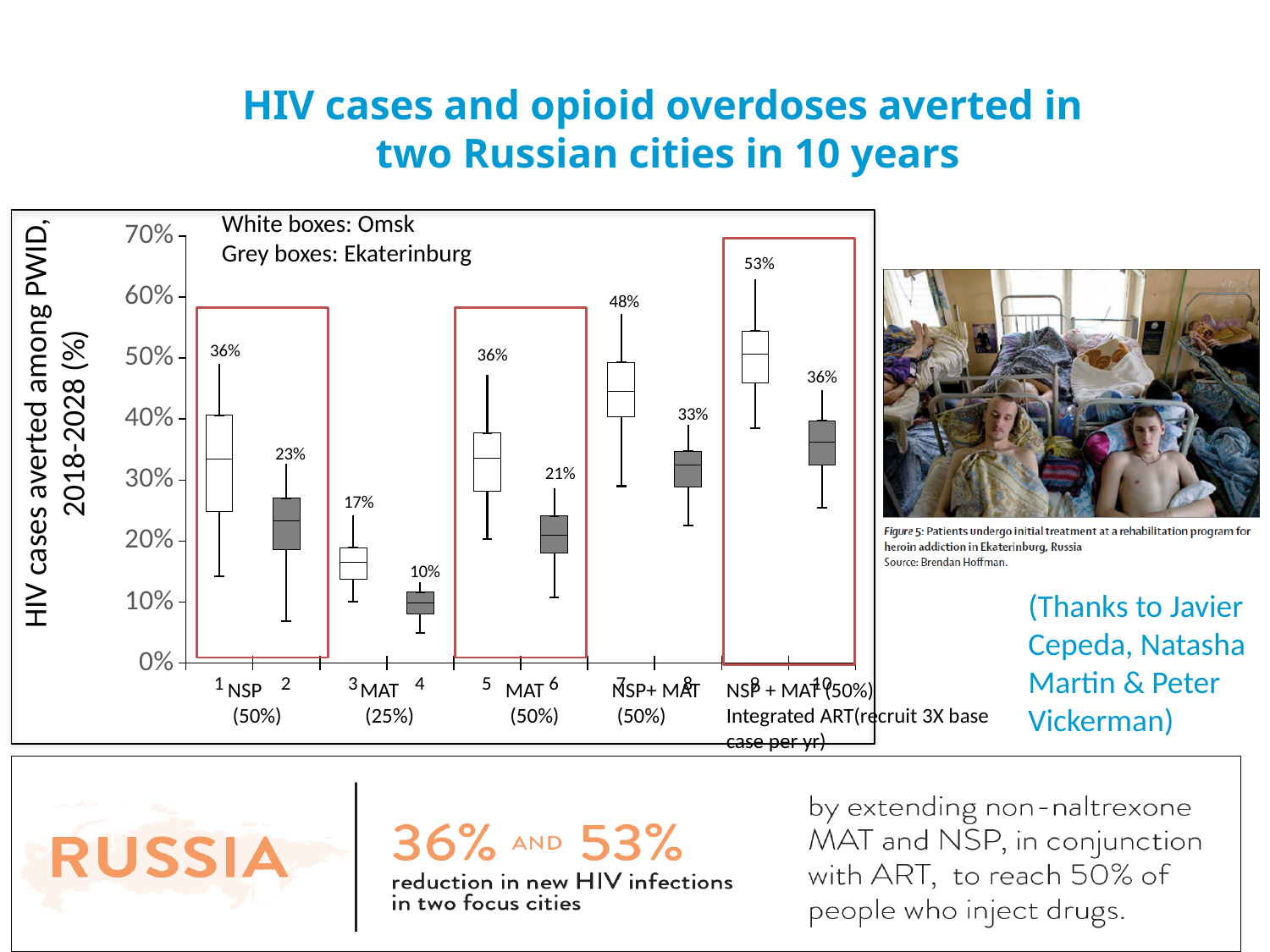
Which city do the grey boxes represent? Ekaterinburg What is the difference between the Omsk labelled values for the MAT (50%) and MAT (25%) scenarios? 19% What is the labelled value for Ekaterinburg (grey box) under the MAT (25%) scenario? 10% What is the labelled value for Omsk under the NSP + MAT (50%) Integrated ART scenario? 53% What is the difference between the Omsk and Ekaterinburg labelled values under the NSP (50%) scenario? 13% Which scenario has the highest labelled value for Omsk (white boxes)? NSP + MAT (50%) Integrated ART Which scenario has the lowest labelled value for Ekaterinburg (grey boxes)? MAT (25%) Which is larger: the Omsk value under MAT (50%) or the Omsk value under NSP+ MAT (50%)? NSP+ MAT (50%) What is the label of the y-axis? HIV cases averted among PWID, 2018-2028 (%) What is the labelled median HIV cases averted for Omsk (white box) under the NSP (50%) scenario? 36% What is the labelled value for Ekaterinburg under the NSP+ MAT (50%) scenario? 33% How many boxes are plotted in the chart? 10